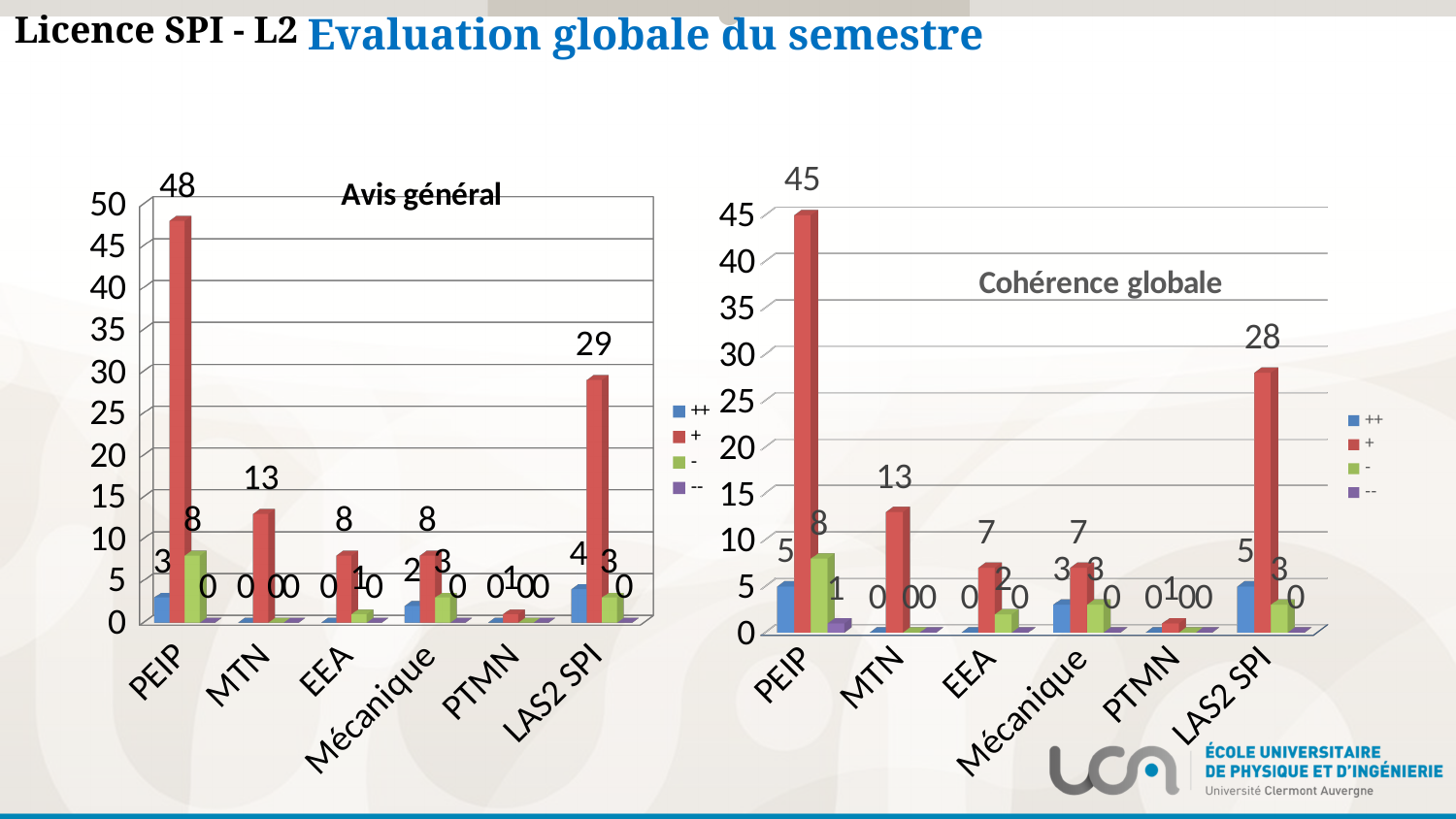
In the 'Avis général' chart, what is the value of the '+' series for PEIP? 48 How many series does the legend of the 'Cohérence globale' chart list? 4 In the 'Cohérence globale' chart, which category has the lowest '+' value? PTMN What type of chart is the 'Avis général' chart? Bar chart In the 'Cohérence globale' chart, what is the value of the '+' series for PEIP? 45 In the 'Cohérence globale' chart, what is the value of the '+' series for MTN? 13 In the 'Avis général' chart, which category has the highest '+' value? PEIP In the 'Cohérence globale' chart, which is larger: the '+' value for EEA or the '+' value for LAS2 SPI? LAS2 SPI In the 'Avis général' chart, what is the difference between the '+' values for PEIP and LAS2 SPI? 19 In the 'Cohérence globale' chart, what is the total of the four series for PEIP? 59 How many categories are shown on the x axis of the 'Avis général' chart? 6 In the 'Avis général' chart, what is the value of the '+' series for LAS2 SPI? 29